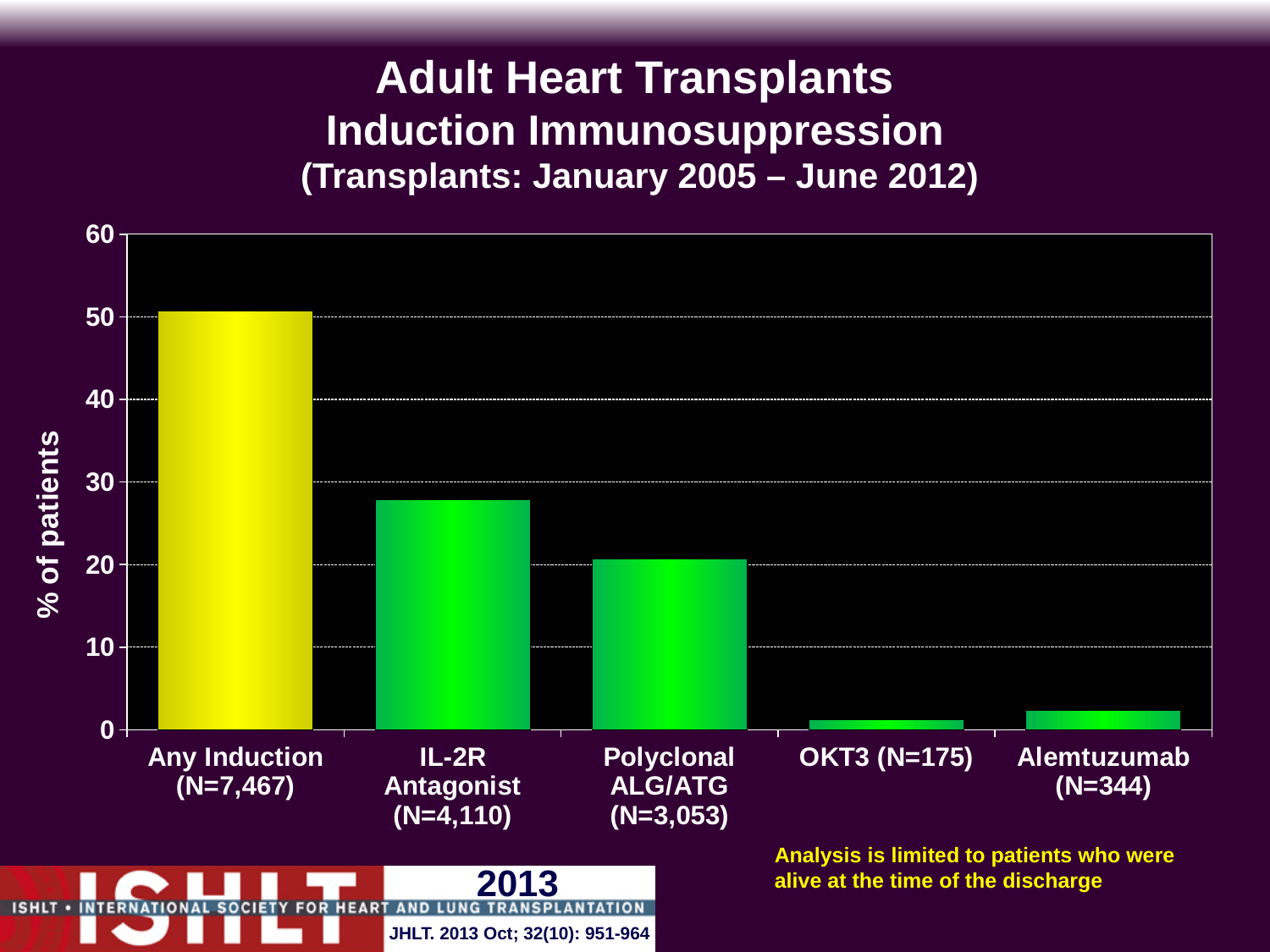
What is the N shown for the Any Induction category? 7,467 Which has a higher percentage of patients, Alemtuzumab or OKT3? Alemtuzumab What is the label of the y axis? % of patients Which category has the lowest percentage of patients? OKT3 Which category has the highest percentage of patients? Any Induction How many categories are shown on the x axis? 5 Is the value for Polyclonal ALG/ATG greater or less than 30? less What kind of chart is shown on the slide? bar chart Which has a higher percentage of patients, IL-2R Antagonist or Polyclonal ALG/ATG? IL-2R Antagonist Is the value for IL-2R Antagonist greater or less than 30? less Is the value for OKT3 greater or less than 10? less